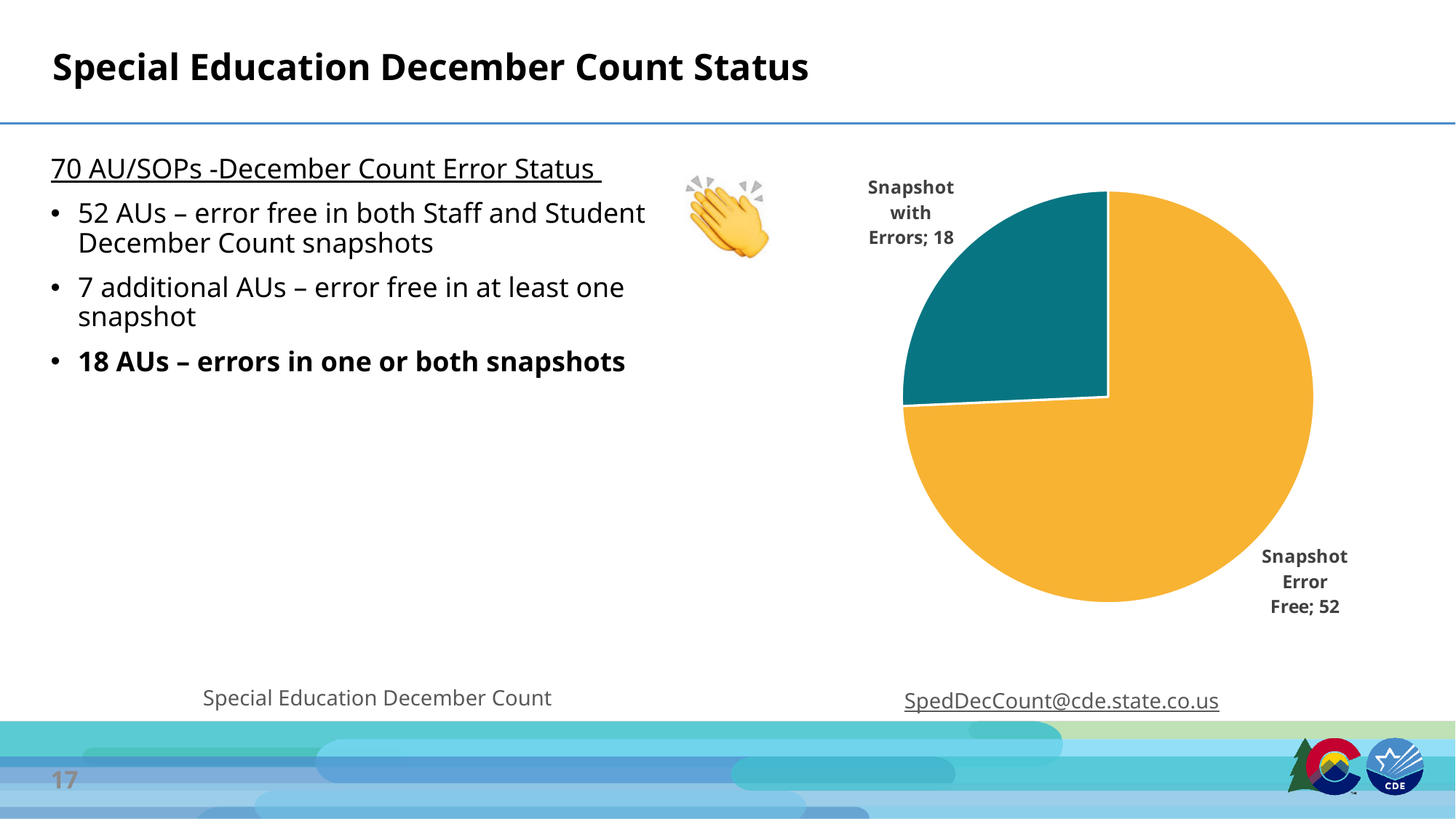
What is the value for the 'Snapshot Error Free' slice? 52 Which slice of the pie chart is the smallest? Snapshot with Errors What is the value for the 'Snapshot with Errors' slice? 18 What colour is the 'Snapshot Error Free' slice? yellow What is the total of the two slices in the pie chart? 70 What colour is the 'Snapshot with Errors' slice? teal What kind of chart is shown on the slide? pie chart Which is larger, 'Snapshot Error Free' or 'Snapshot with Errors'? Snapshot Error Free How many slices does the pie chart have? 2 What is the difference between the 'Snapshot Error Free' and 'Snapshot with Errors' values? 34 What share of the pie does the 'Snapshot Error Free' slice represent? 74.3% Which slice of the pie chart is the largest? Snapshot Error Free